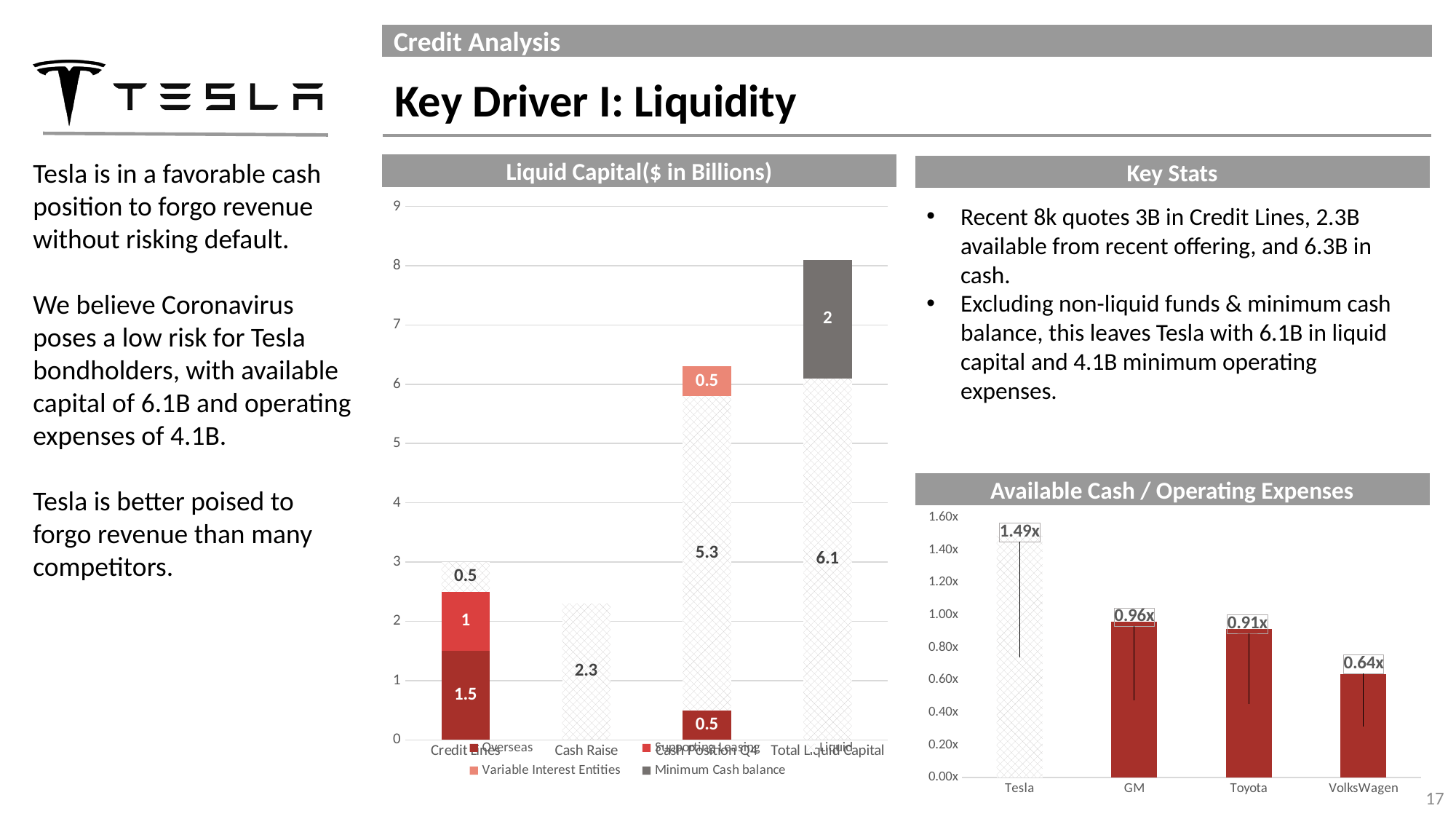
In the Available Cash / Operating Expenses chart, what is the difference between the values for GM and Toyota? 0.05x In the Available Cash / Operating Expenses chart, which company has the highest value? Tesla In the Available Cash / Operating Expenses chart, which company has the lowest value? VolksWagen In the Available Cash / Operating Expenses chart, do the values rise or fall from Tesla to VolksWagen? fall In the Available Cash / Operating Expenses chart, is the value for Tesla greater or less than 1.40x? greater In the Available Cash / Operating Expenses chart, what is the value for GM? 0.96x In the Liquid Capital($ in Billions) chart, what is the total of the Credit Lines stacked bar? 3 In the Liquid Capital($ in Billions) chart, what is the value of the Minimum Cash balance segment on the Total Liquid Capital bar? 2 In the Liquid Capital($ in Billions) chart, what is the value labelled for Cash Raise? 2.3 In the Available Cash / Operating Expenses chart, how many companies are shown? 4 What kind of chart is the Available Cash / Operating Expenses chart? bar chart In the Available Cash / Operating Expenses chart, what is the value for Tesla? 1.49x